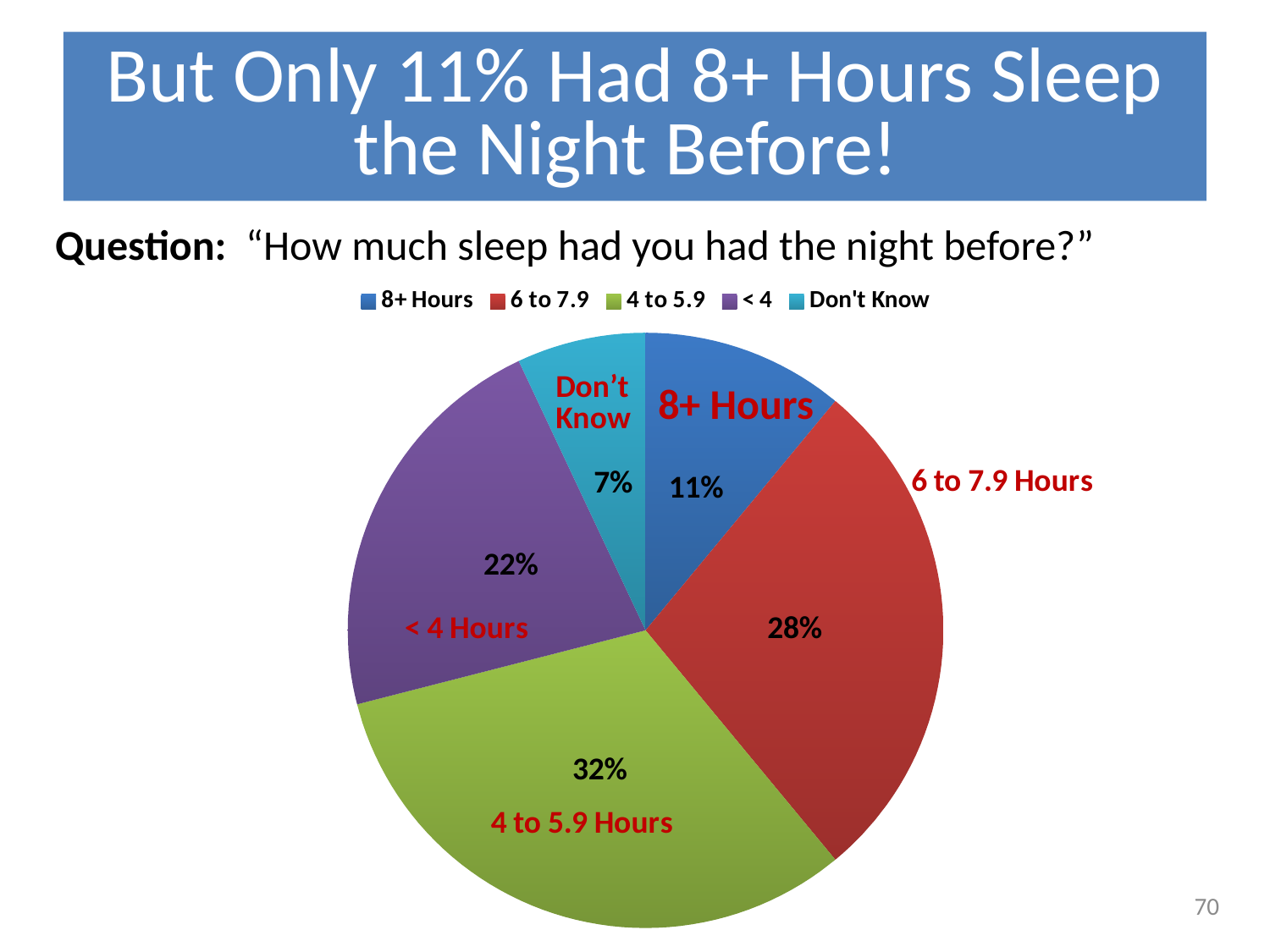
What percentage of respondents answered Don't Know? 7% What percentage of respondents had less than 4 hours of sleep? 22% Which slice is larger: < 4 Hours or 6 to 7.9 Hours? 6 to 7.9 Hours What percentage of respondents had 8+ hours of sleep the night before? 11% What is the difference in percentage points between the 6 to 7.9 Hours slice and the 8+ Hours slice? 17 What percentage of respondents had 4 to 5.9 hours of sleep? 32% What type of chart is shown on the slide? Pie chart What colour is the 4 to 5.9 Hours slice? Green Which sleep category has the smallest share of the pie? Don't Know Which sleep category has the largest share of the pie? 4 to 5.9 Hours How many slices does the pie chart have? 5 How many entries does the legend list? 5